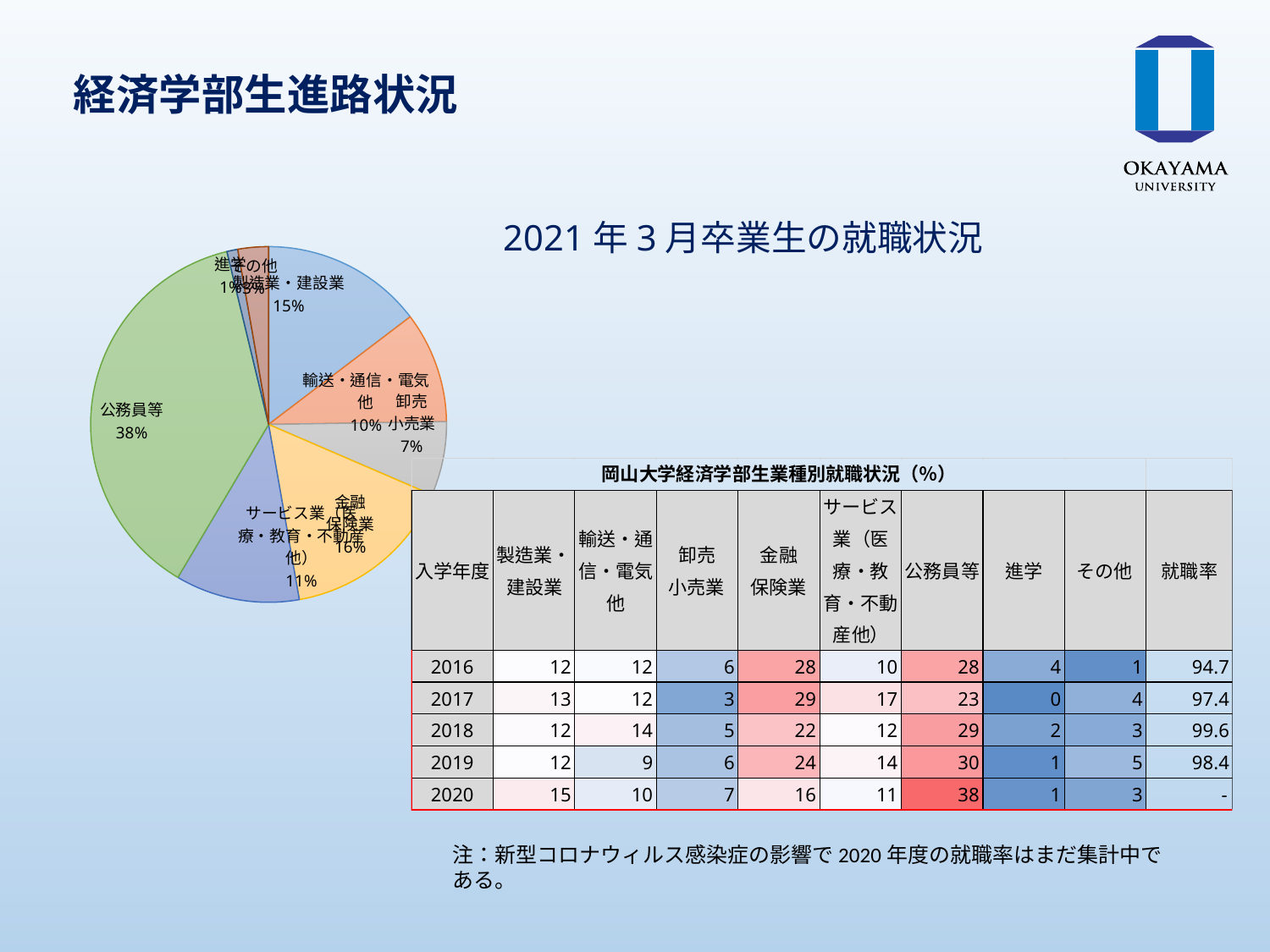
What share of the pie chart is 金融保険業? 16% What share of the pie chart is 製造業・建設業? 15% What is the heading above the pie chart and table? 2021年3月卒業生の就職状況 What is the difference in percentage points between the 公務員等 slice and the 製造業・建設業 slice in the pie chart? 23 Which category has the largest slice in the pie chart? 公務員等 What share of the pie chart is 輸送・通信・電気他? 10% What kind of chart is shown on the slide? Pie chart Which slice is larger in the pie chart, 公務員等 or 金融保険業? 公務員等 Which slice is larger in the pie chart, 製造業・建設業 or 卸売小売業? 製造業・建設業